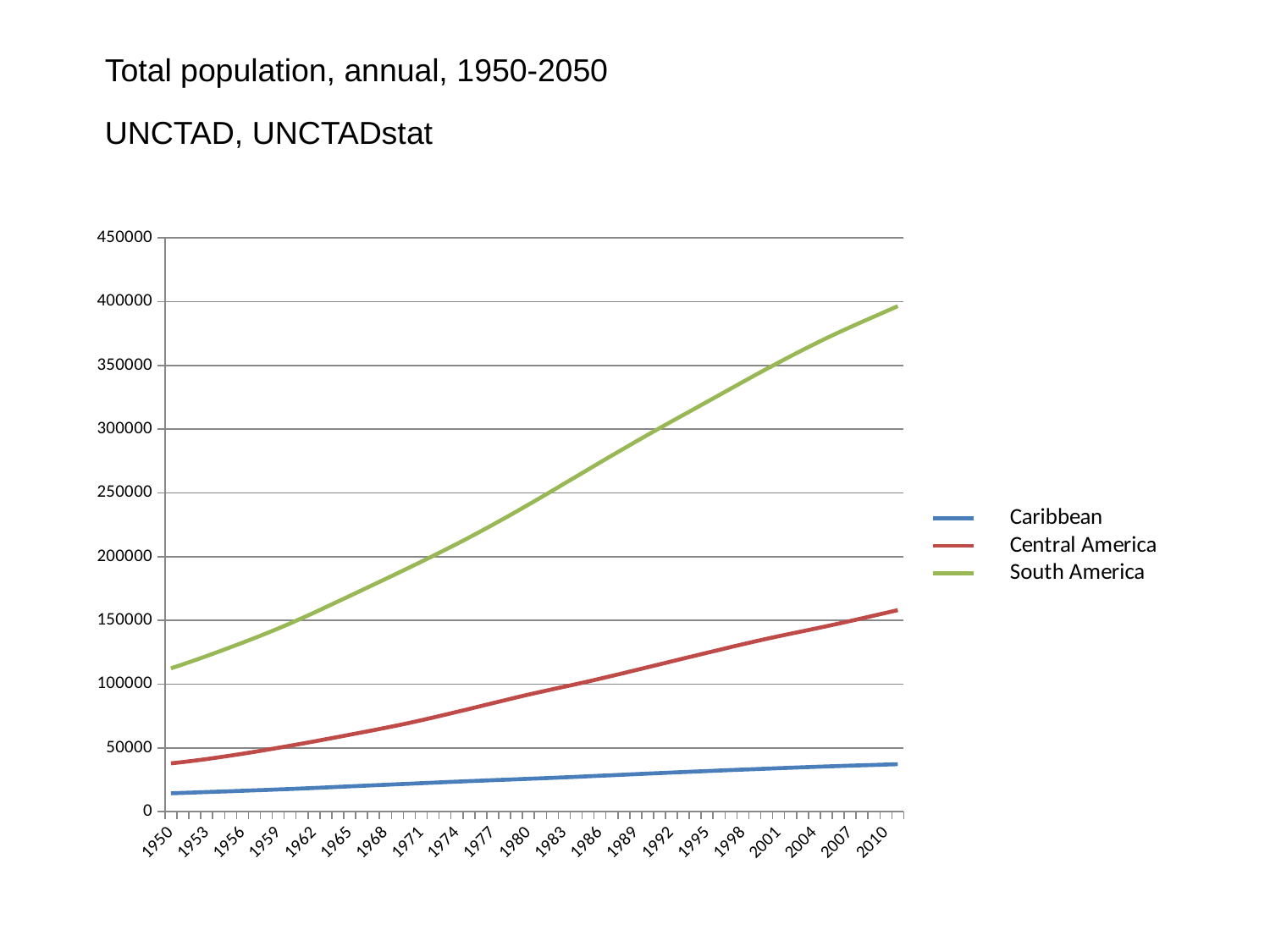
Is the value for South America in 2010 greater or less than 350000? greater What is the title shown above the chart? Total population, annual, 1950-2050 Is the value for South America in 1950 greater or less than 100000? greater Does the South America line rise or fall from 1950 to 2010? rise Is the value for Caribbean in 2010 greater or less than 50000? less Which colour is used for the Central America line? red How many series does the legend list? 3 Which series has the lowest values across the whole period? Caribbean What kind of chart is shown on the slide? line chart Which series has the highest values across the whole period? South America Which is larger in 2010, the value for Central America or the value for Caribbean? Central America